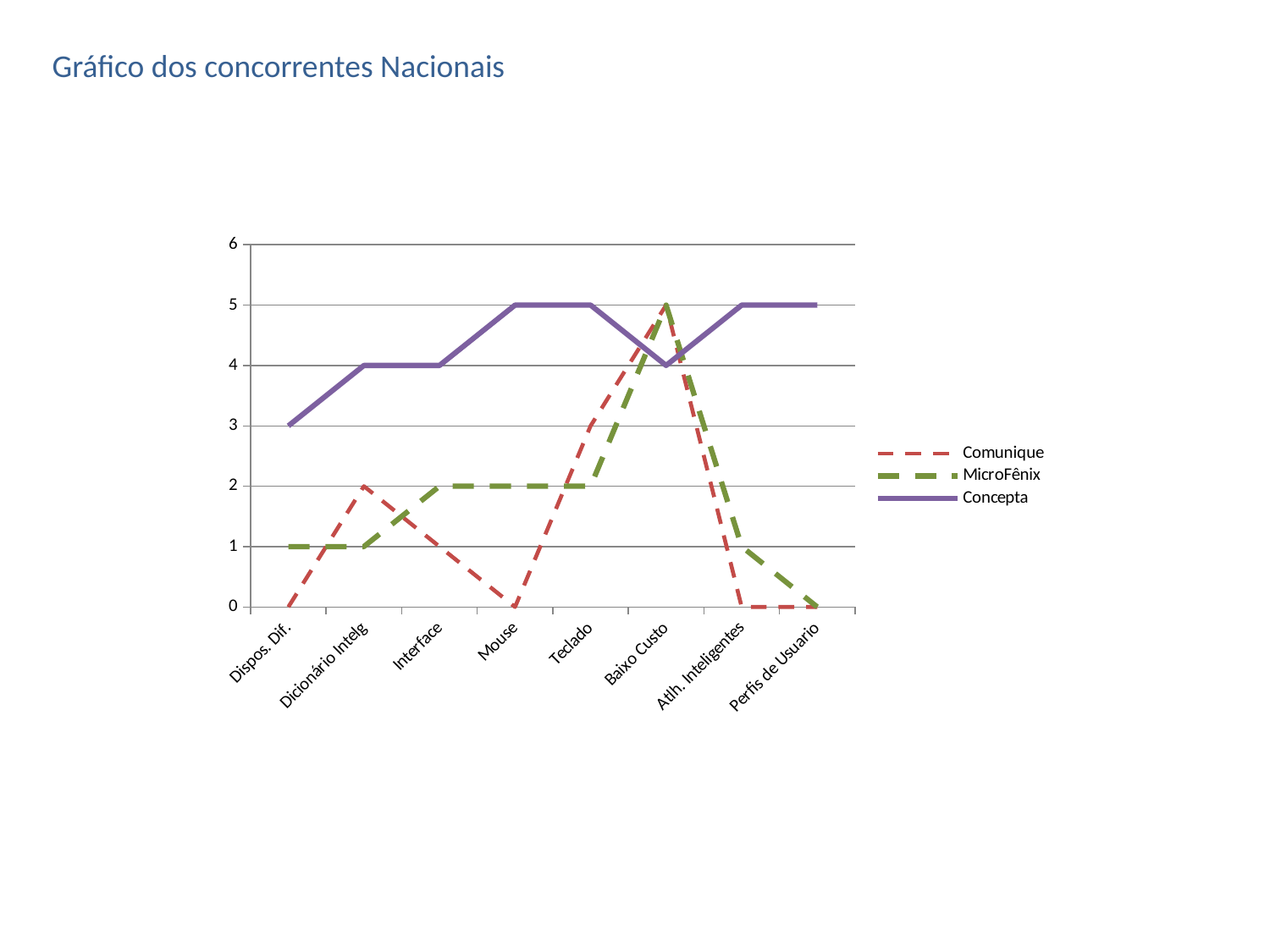
At which category does Comunique reach its highest value? Baixo Custo What is the title of the chart on the slide? Gráfico dos concorrentes Nacionais How many series does the legend list? 3 What is the value for Concepta at Baixo Custo? 4 What is the value for Concepta at Dispos. Dif.? 3 What type of chart is shown on the slide? line chart Which is larger at Dicionário Intelg, Comunique or MicroFênix? Comunique At which category does Concepta have its lowest value? Dispos. Dif. What is the difference between Concepta and Comunique at Mouse? 5 How many categories are shown on the x axis? 8 What is the value for Comunique at Baixo Custo? 5 What is the value for MicroFênix at Interface? 2